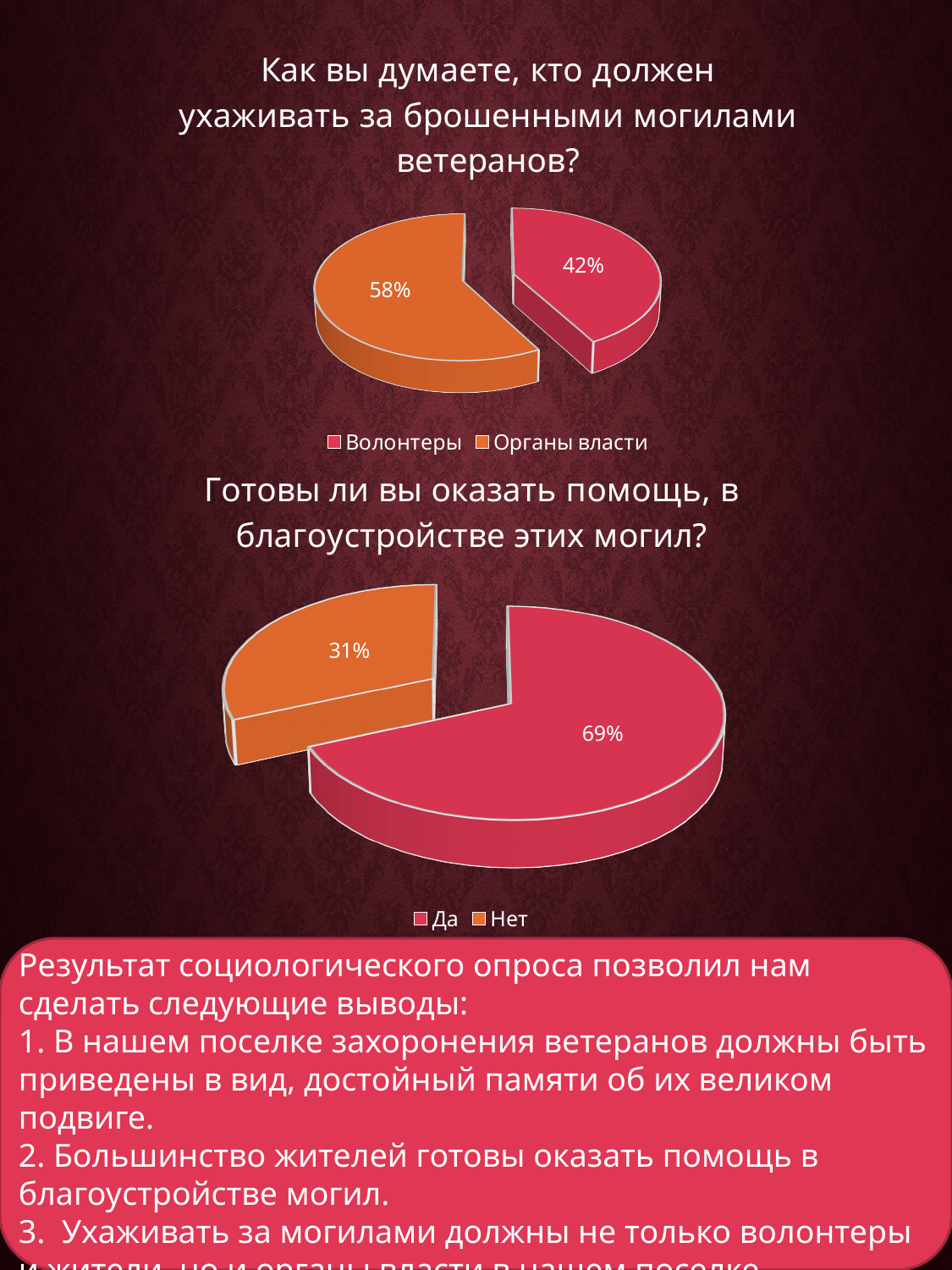
In the top chart, which colour represents Волонтеры in the legend? Pink/red In the bottom chart, which category has the smaller slice? Нет In the top chart ("Как вы думаете, кто должен ухаживать за брошенными могилами ветеранов?"), what share is shown for Органы власти? 58% In the bottom chart ("Готовы ли вы оказать помощь, в благоустройстве этих могил?"), what share is shown for Да? 69% In the bottom chart, what is the difference between the Да and Нет shares? 38% In the top chart, how many slices does the pie have? 2 In the bottom chart, how many entries does the legend list? 2 In the top chart ("Как вы думаете, кто должен ухаживать за брошенными могилами ветеранов?"), what share is shown for Волонтеры? 42% In the top chart, what is the difference between the Органы власти and Волонтеры shares? 16% What type of chart is the top chart? Pie chart In the bottom chart ("Готовы ли вы оказать помощь, в благоустройстве этих могил?"), what share is shown for Нет? 31% In the top chart, which category has the larger slice? Органы власти